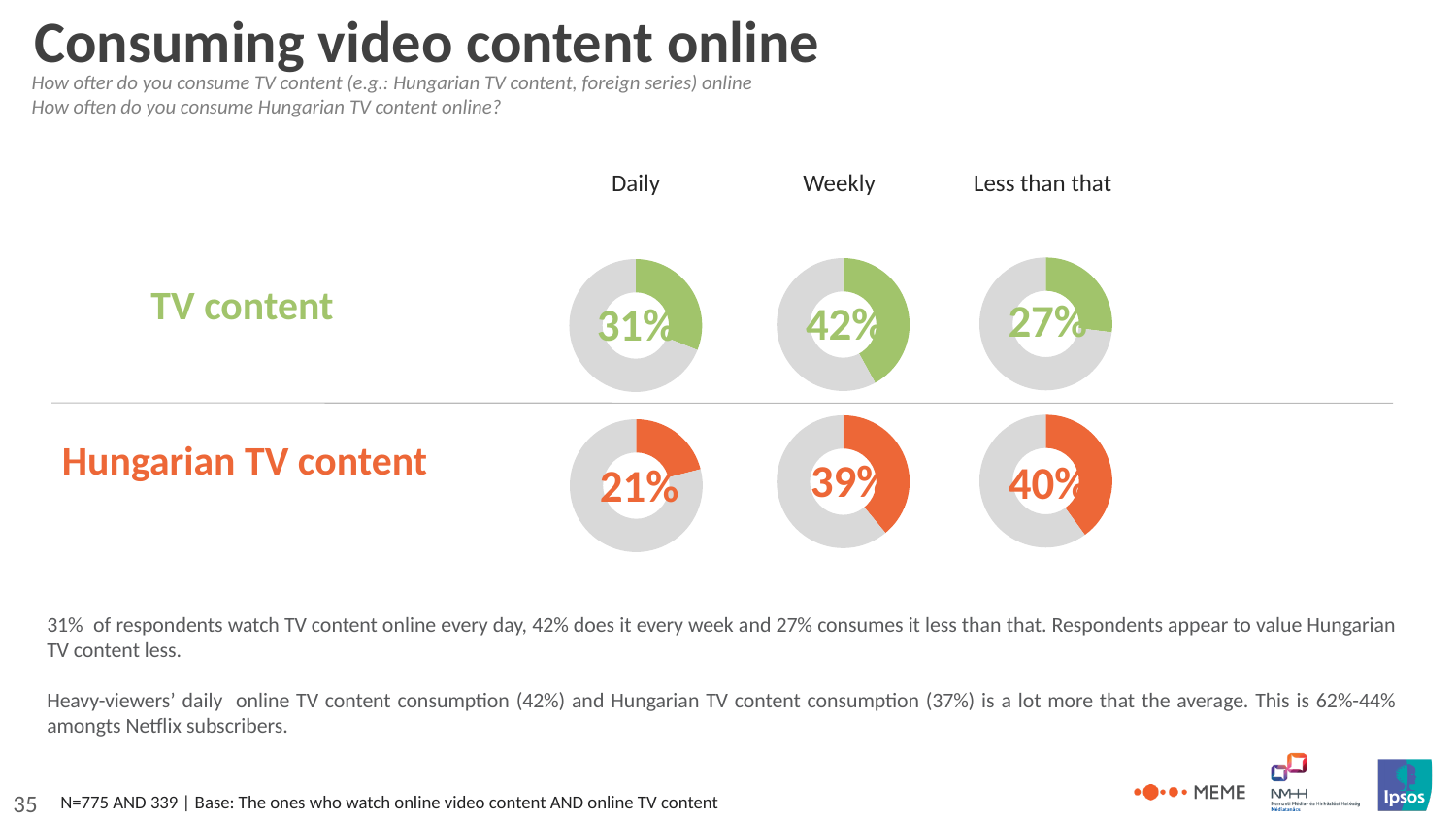
Across the three TV content donut charts, which frequency has the highest value? Weekly How many donut charts are shown on the slide? 6 In the Hungarian TV content row, what value is shown in the Daily donut chart? 21% What colour are the filled segments in the Hungarian TV content donut charts? Orange What kind of chart is used to show the values on this slide? Donut (pie) chart What percentage of respondents consume TV content online daily, according to the TV content Daily donut chart? 31% Which is larger: the Weekly value for TV content or the Weekly value for Hungarian TV content? TV content What is the difference between the 'Less than that' values for Hungarian TV content (40%) and TV content (27%)? 13% In the Hungarian TV content row, what value is shown in the 'Less than that' donut chart? 40% Across the three Hungarian TV content donut charts, which frequency has the lowest value? Daily In the TV content row, what value is shown in the Weekly donut chart? 42% What is the difference between the Daily values for TV content (31%) and Hungarian TV content (21%)? 10%